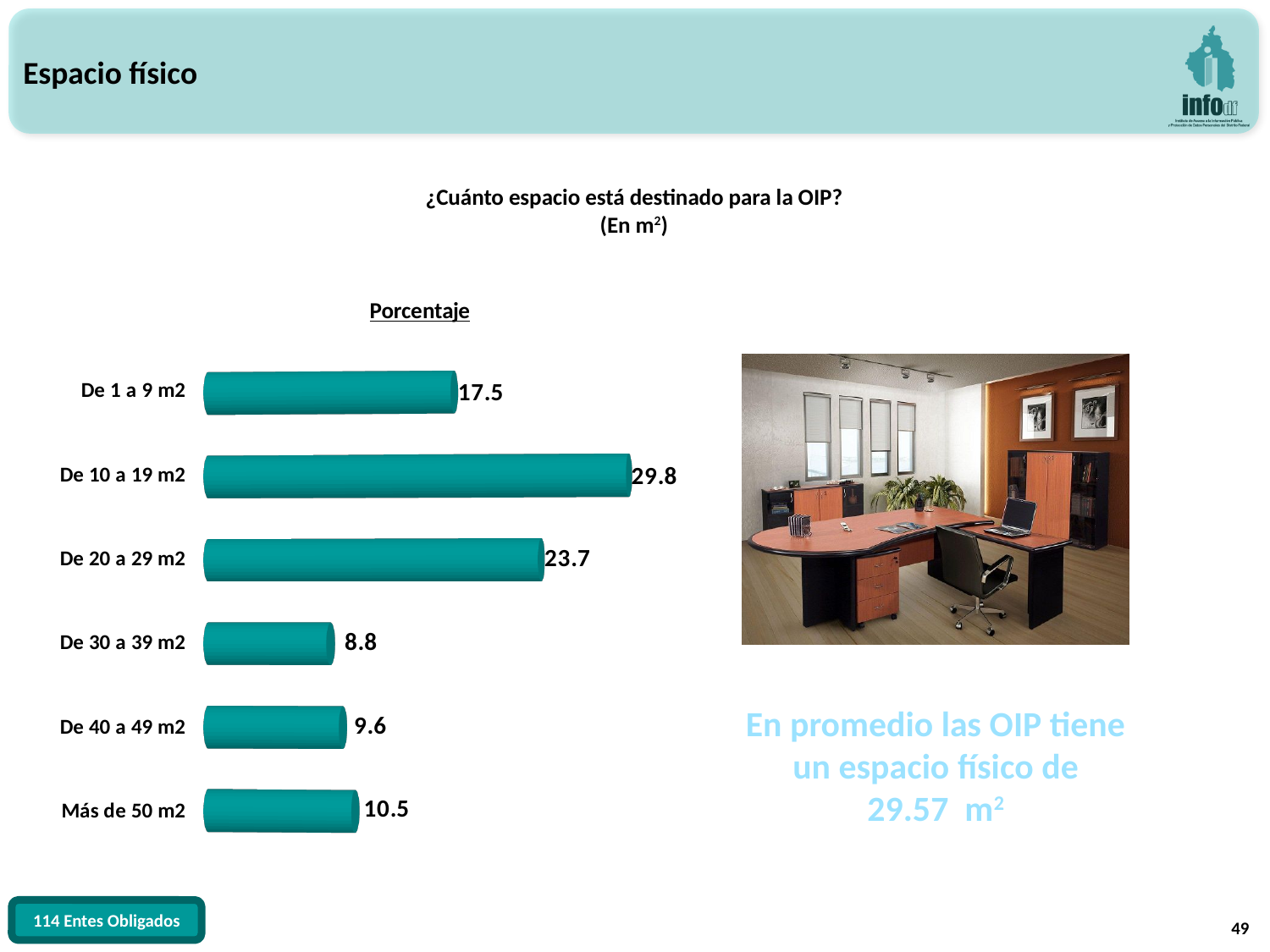
Which category has the lowest value? De 30 a 39 m2 Which is larger, the value for 'De 20 a 29 m2' or the value for 'De 1 a 9 m2'? De 20 a 29 m2 Which is larger, the value for 'Más de 50 m2' or the value for 'De 40 a 49 m2'? Más de 50 m2 How many categories are shown in the chart? 6 Which category has the highest value? De 10 a 19 m2 What kind of chart is shown on the slide? Bar chart What is the difference between the values for 'De 10 a 19 m2' and 'De 20 a 29 m2'? 6.1 What is the value for 'De 10 a 19 m2'? 29.8 What is the value for 'De 30 a 39 m2'? 8.8 What is the label shown above the chart? Porcentaje What is the difference between the values for 'De 1 a 9 m2' and 'De 40 a 49 m2'? 7.9 What is the value for 'Más de 50 m2'? 10.5